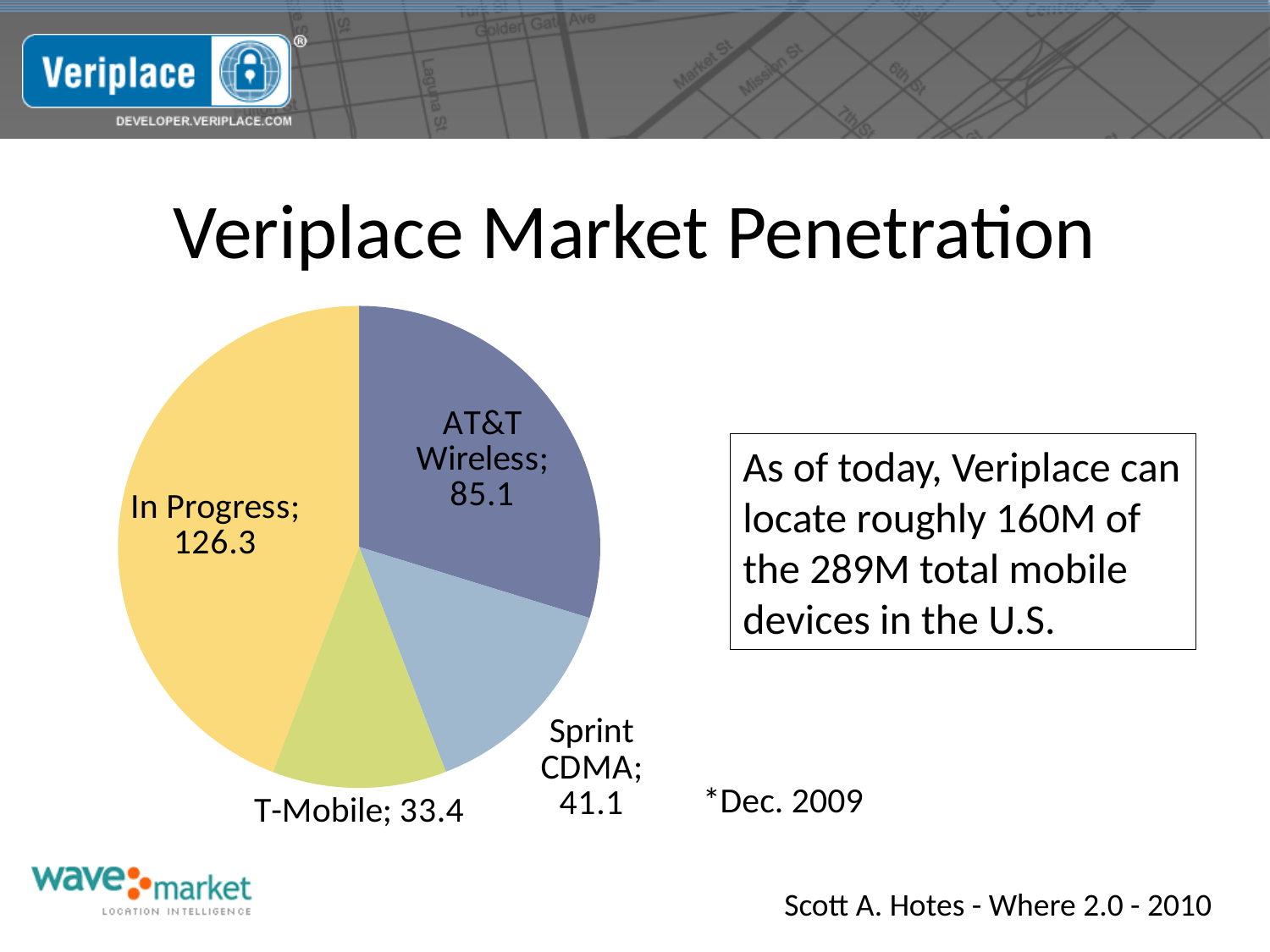
What colour is the In Progress slice of the pie chart? Yellow What is the value shown for the In Progress slice? 126.3 What kind of chart is shown on the slide? Pie chart Which is larger, the value for AT&T Wireless or the value for Sprint CDMA? AT&T Wireless Which slice of the pie chart has the smallest value? T-Mobile Which slice of the pie chart has the largest value? In Progress What is the value shown for AT&T Wireless in the pie chart? 85.1 How many slices does the pie chart have? 4 What is the difference between the Sprint CDMA value and the T-Mobile value? 7.7 What is the difference between the In Progress value and the AT&T Wireless value? 41.2 What value is labelled for Sprint CDMA? 41.1 What value is labelled for T-Mobile? 33.4